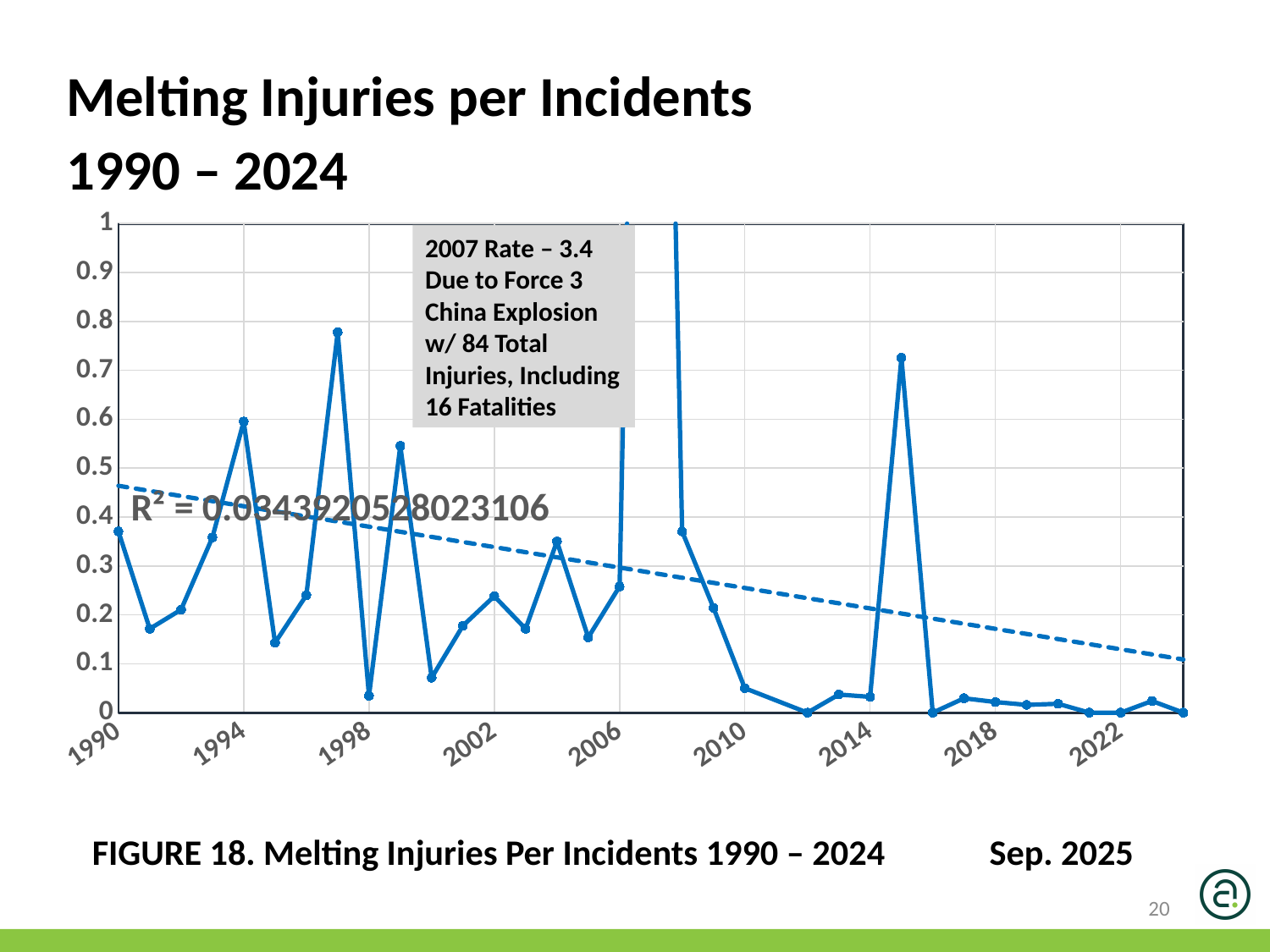
Is the value for 2010 greater or less than 0.1? less According to the annotation on the chart, what was the rate in 2007? 3.4 Does the dashed trendline rise or fall from 1990 to 2024? fall Is the value for 2015 greater or less than 0.7? greater Is the value for 1997 greater or less than 0.7? greater What kind of chart is shown on the slide? line chart What R² value is printed on the chart? R² = 0.0343920528023106 What is the title of the chart on the slide? Melting Injuries per Incidents 1990 – 2024 Which year has the larger value, 1997 or 1994? 1997 Which year has the highest melting injuries per incident value? 2007